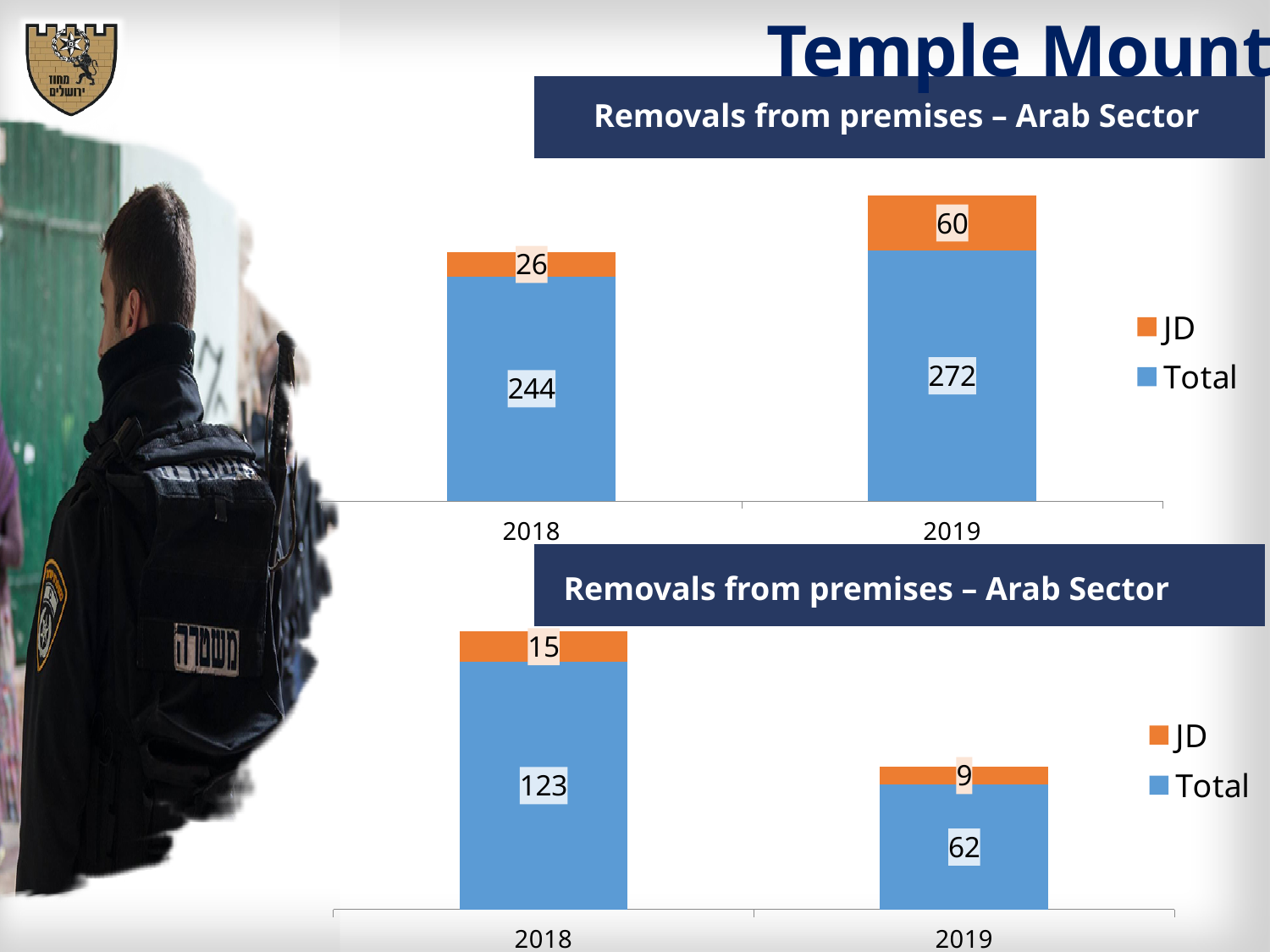
In the top chart, which year has the higher Total value? 2019 In the top chart, what is the JD value for 2019? 60 In the top chart, what is the difference between the JD values for 2019 and 2018? 34 In the bottom chart, what is the JD value for 2018? 15 In the bottom chart, what is the difference between the Total values for 2018 and 2019? 61 What kind of chart is the bottom chart? Stacked bar chart In the bottom chart, which year has the lower JD value? 2019 How many series does the legend of the top chart list? 2 In the bottom chart, what is the Total value for 2019? 62 In the top chart, what is the Total value for 2018? 244 In the top chart, what is the combined height of the stacked bar for 2019 (Total plus JD)? 332 In the bottom chart, what is the combined height of the stacked bar for 2018 (Total plus JD)? 138